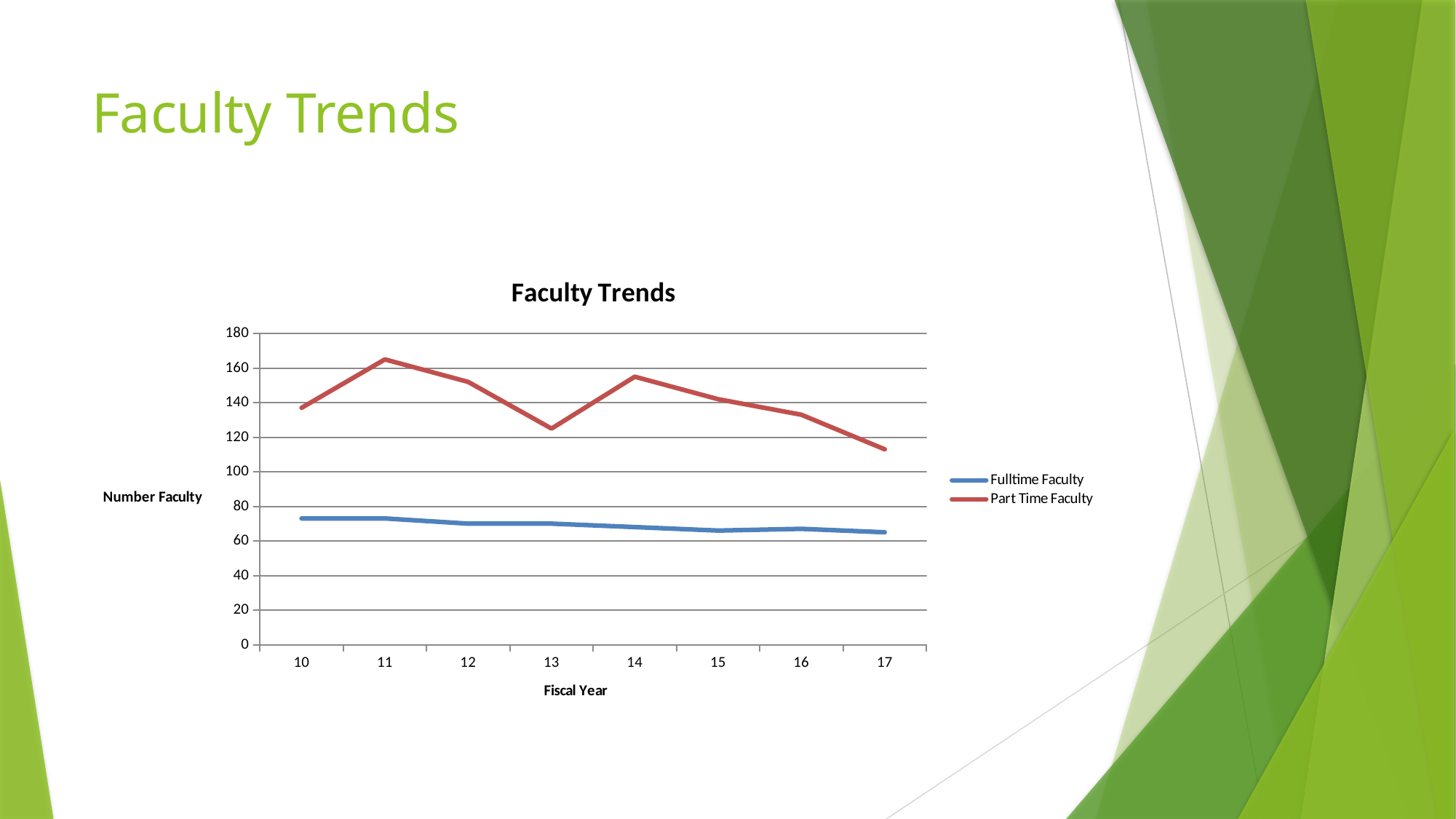
Is the value for Part Time Faculty in fiscal year 11 greater or less than 160? greater In which fiscal year is Part Time Faculty lowest? 17 Is the value for Part Time Faculty in fiscal year 17 greater or less than 120? less In which fiscal year is Part Time Faculty highest? 11 Which is larger for Part Time Faculty, fiscal year 11 or fiscal year 13? fiscal year 11 How many fiscal years are plotted on the x axis? 8 What is the label of the y axis? Number Faculty Which is larger in fiscal year 17, Fulltime Faculty or Part Time Faculty? Part Time Faculty Is the value for Fulltime Faculty in fiscal year 10 greater or less than 80? less Does Fulltime Faculty generally rise or fall from fiscal year 10 to 17? fall How many series does the legend list? 2 What kind of chart is shown on the slide? line chart